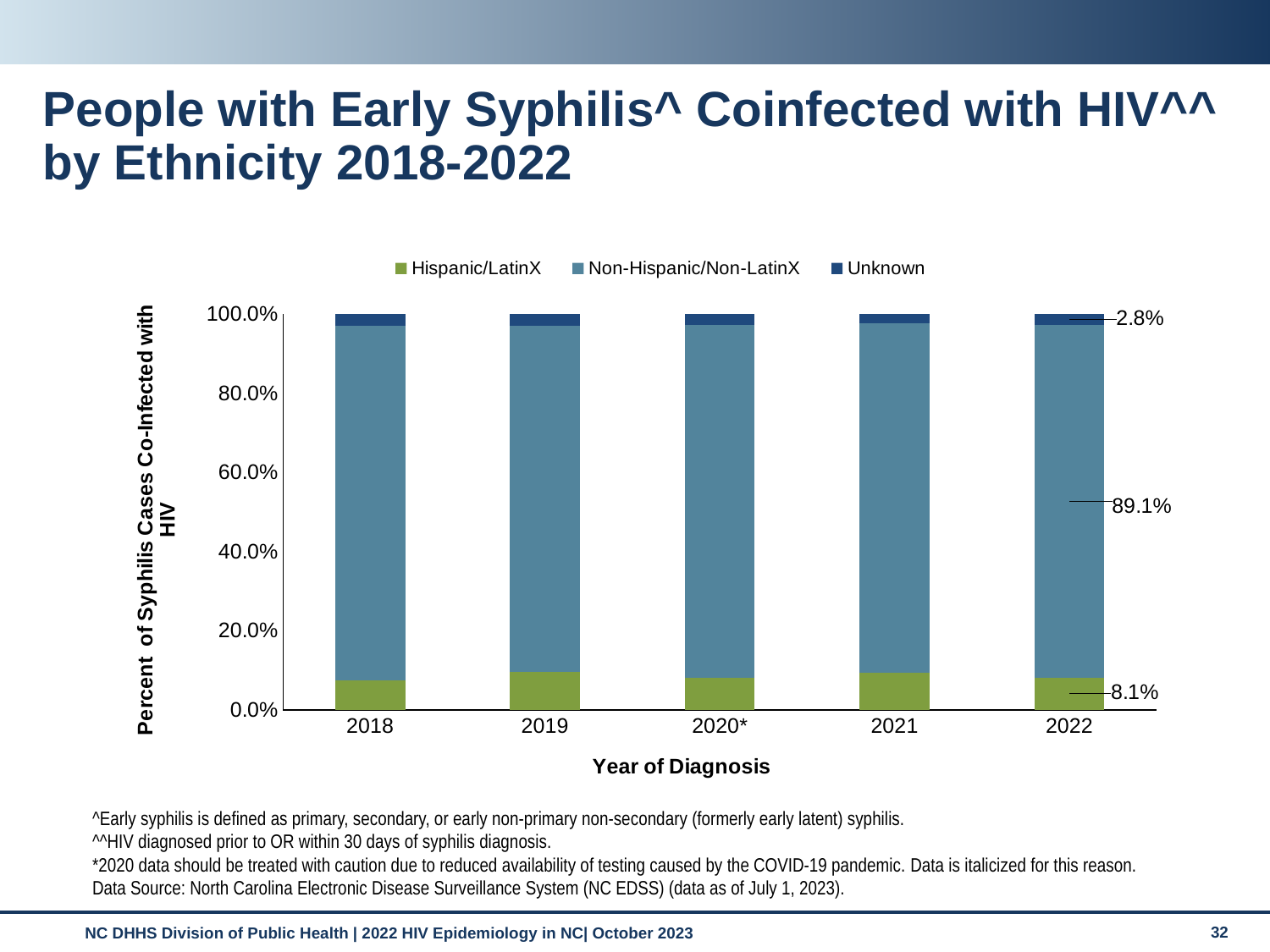
What percentage of the 2022 bar is Hispanic/LatinX? 8.1% How many years of diagnosis are shown on the x axis? 5 Is the Non-Hispanic/Non-LatinX share in 2018 greater or less than 80.0%? greater Which ethnicity group has the largest share in 2022? Non-Hispanic/Non-LatinX How many series does the legend list? 3 Which ethnicity group has the smallest share in 2022? Unknown Is the Hispanic/LatinX share in 2019 greater or less than 20.0%? less What kind of chart is shown on the slide? Stacked bar chart What percentage of the 2022 bar is Non-Hispanic/Non-LatinX? 89.1% What percentage of the 2022 bar is Unknown? 2.8% What is the total of the three labelled segments in the 2022 bar? 100.0% In 2022, how many percentage points larger is the Non-Hispanic/Non-LatinX share than the Hispanic/LatinX share? 81.0 percentage points